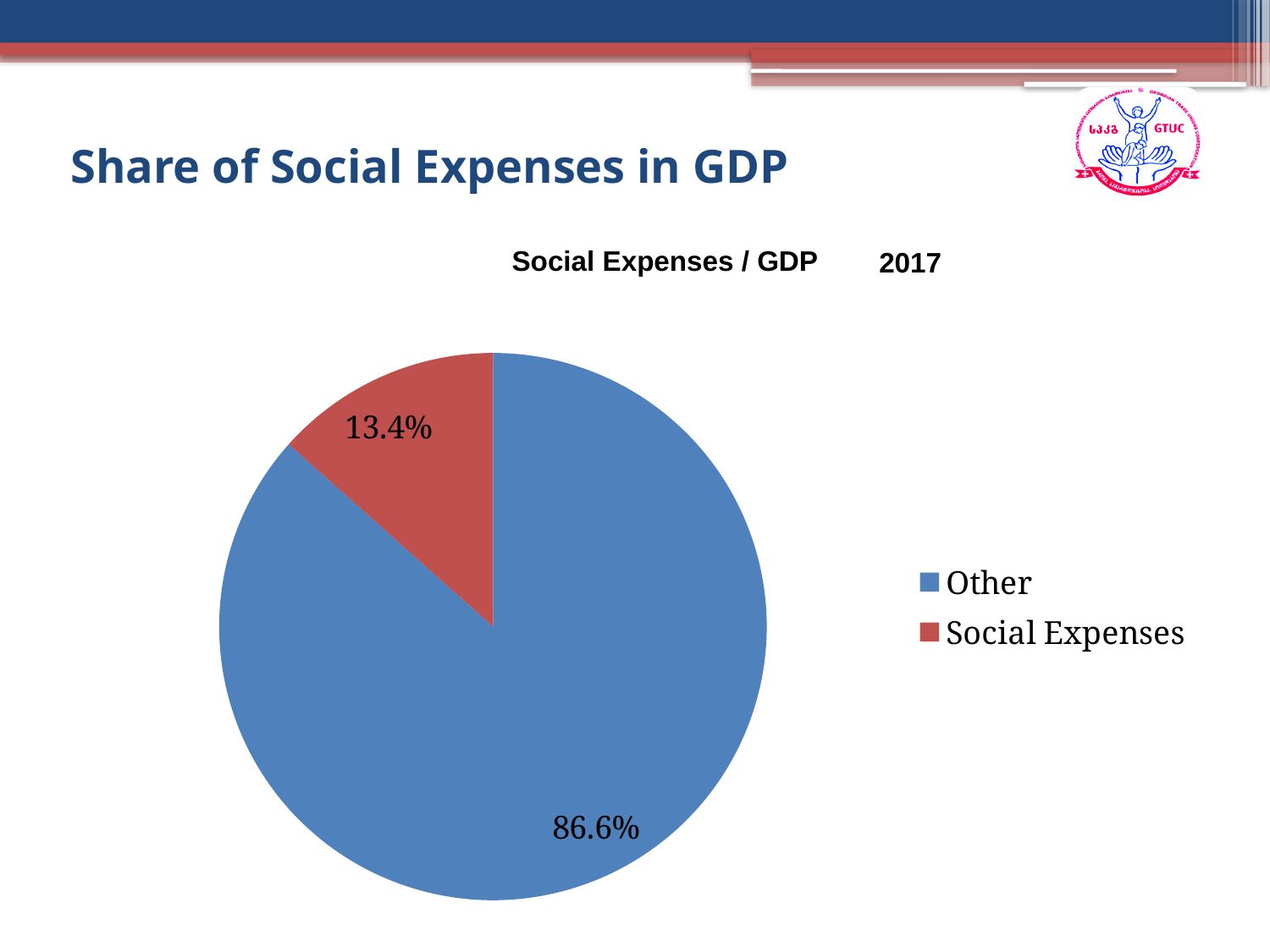
What is the difference between the Other slice and the Social Expenses slice? 73.2% How many slices does the pie chart have? 2 Which slice is the smallest? Social Expenses Which slice is the largest? Other What type of chart is shown on the slide? pie chart What colour is the Social Expenses slice? red What year is shown next to the chart title? 2017 Which is larger, Other or Social Expenses? Other What share of the pie does Social Expenses take? 13.4% What is the title of the chart? Social Expenses / GDP What is the value shown for Other? 86.6% What is the value shown for Social Expenses? 13.4%